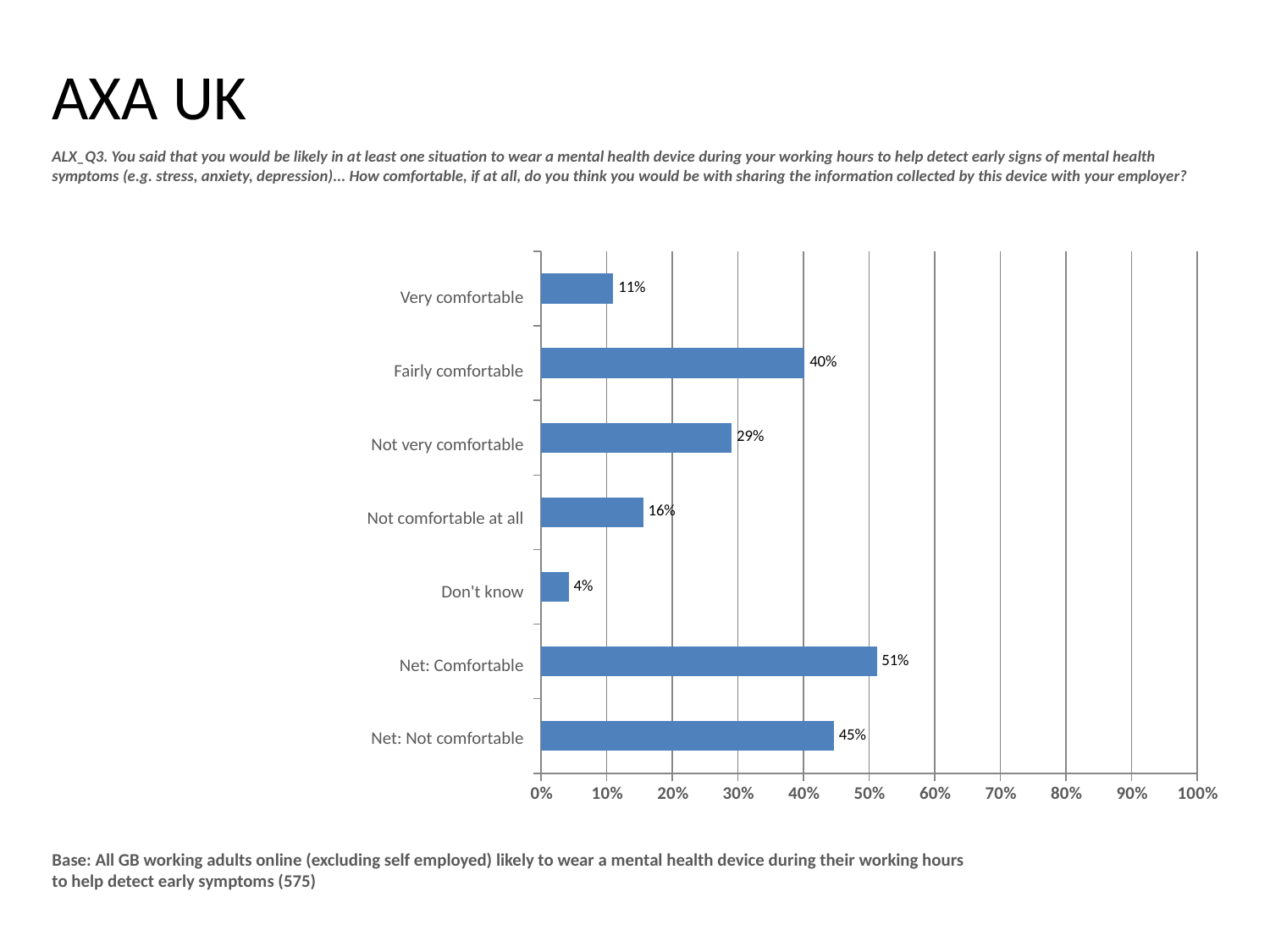
Which is larger, 'Not comfortable at all' or 'Very comfortable'? Not comfortable at all What is the difference between 'Net: Comfortable' and 'Net: Not comfortable'? 6 percentage points What is the difference between 'Fairly comfortable' and 'Not very comfortable'? 11 percentage points What is the value shown for 'Fairly comfortable'? 40% What type of chart is shown on the slide? Bar chart What percentage of respondents said they would be 'Very comfortable' sharing the device information with their employer? 11% Which category has the highest value on the chart? Net: Comfortable What is the value shown for 'Net: Not comfortable'? 45% How many categories are shown on the chart? 7 Is the value for 'Net: Comfortable' greater or less than 50%? greater What is the value shown for 'Not very comfortable'? 29% Which category has the lowest value on the chart? Don't know